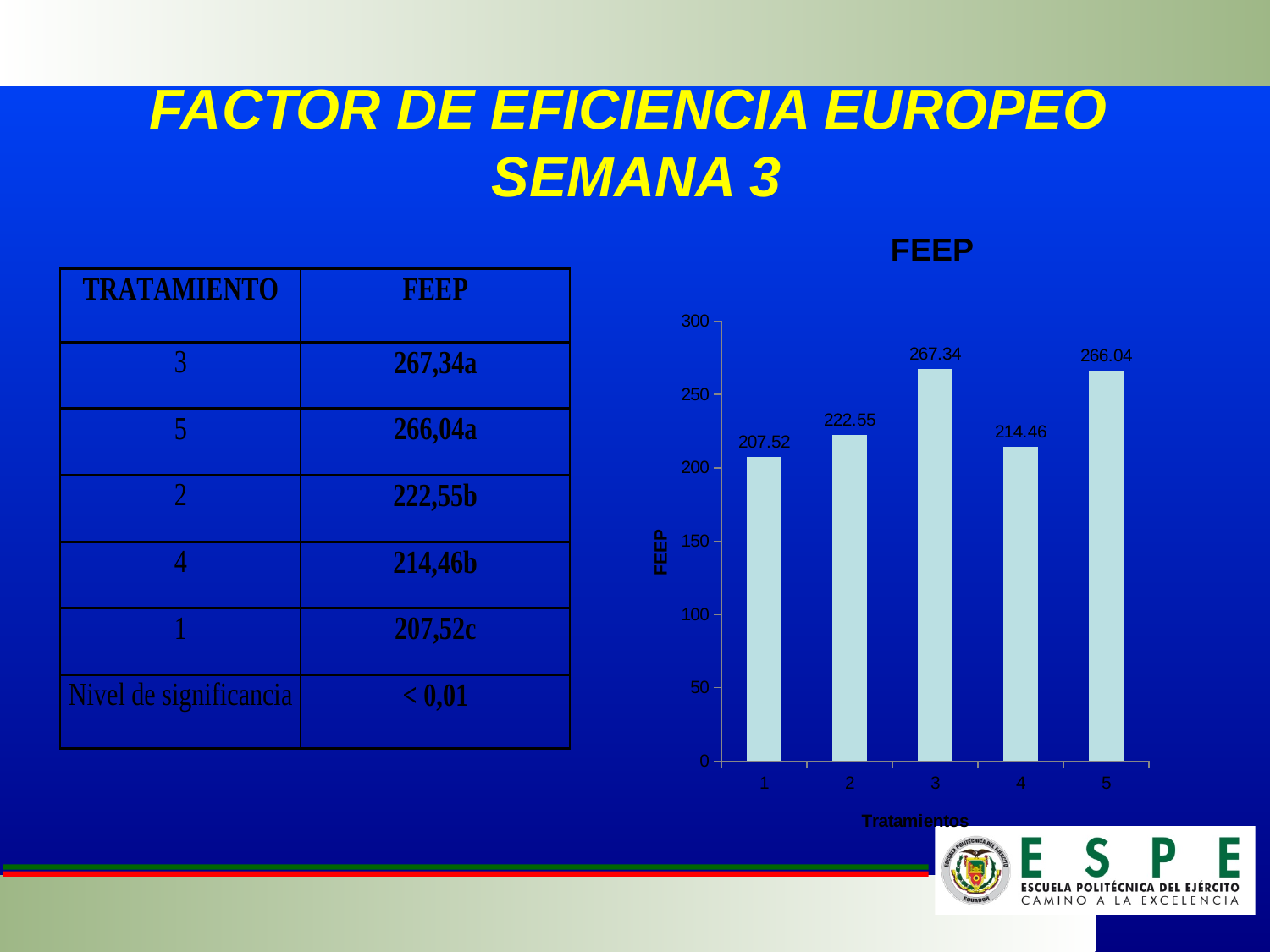
What is the difference between the FEEP values for treatments 2 and 4? 8.09 How many treatments are shown on the x axis of the chart? 5 Which has a larger FEEP value, treatment 2 or treatment 4? Treatment 2 What is the title of the chart? FEEP What is the FEEP value for treatment 3 in the chart? 267.34 What kind of chart is used to show FEEP by treatment? Bar chart What is the FEEP value for treatment 4 in the chart? 214.46 Is the FEEP value for treatment 5 greater or less than 250? greater What is the difference between the FEEP values for treatments 3 and 1? 59.82 Which treatment has the highest FEEP value in the chart? 3 Which treatment has the lowest FEEP value in the chart? 1 What is the FEEP value for treatment 1 in the chart? 207.52